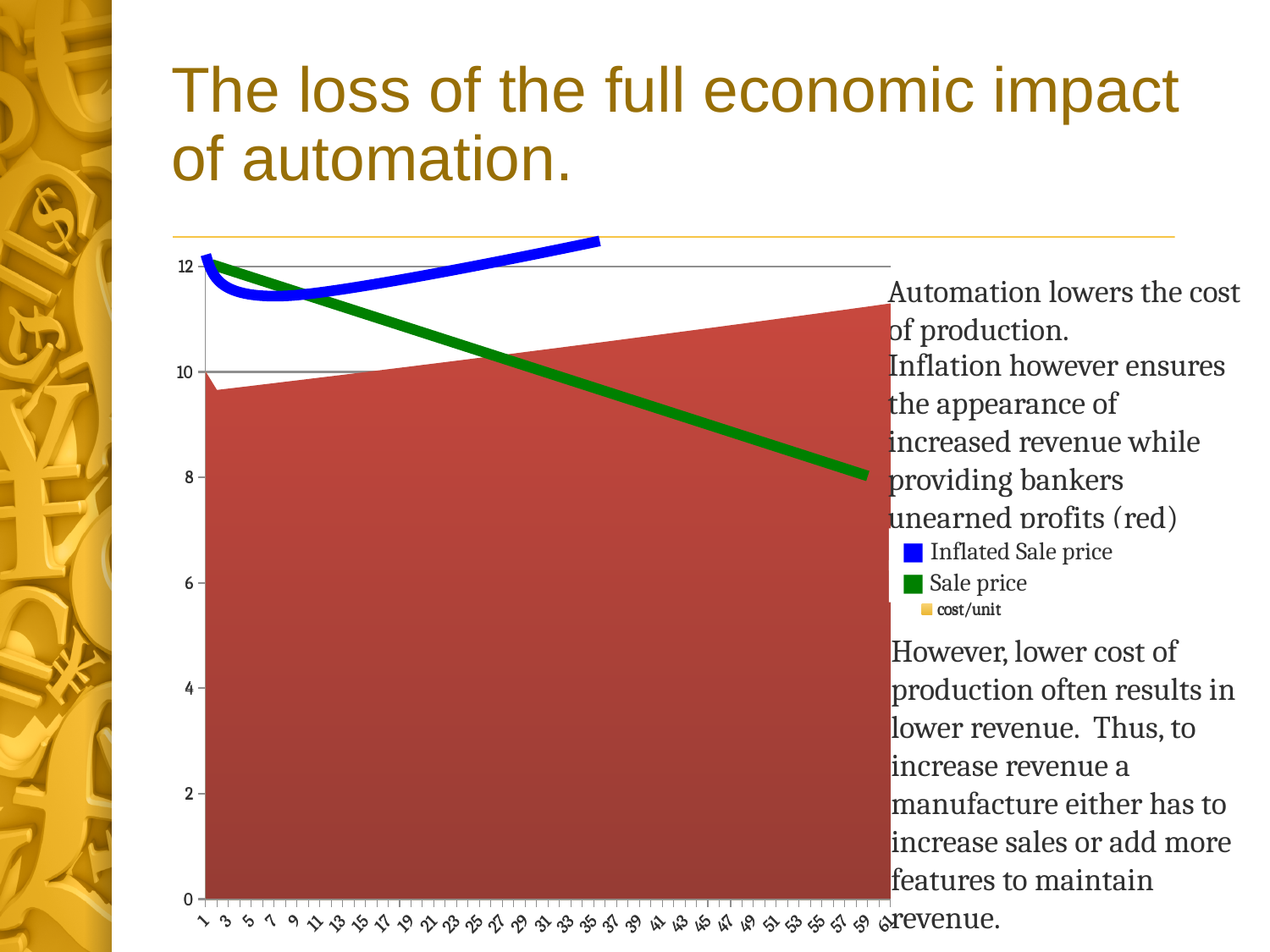
Which colour represents the Sale price series in the legend? green What is the Sale price value at x = 1? 12 What kind of chart is used for the cost/unit series? area chart What is the Sale price value at x = 61? 8 Is the Inflated Sale price value at x = 11 greater or less than 12? less Does the Sale price series rise or fall along the x axis? fall By how much does the Sale price fall between x = 1 and x = 61? 4 At x = 31, which is larger: the Inflated Sale price or the Sale price? Inflated Sale price Is the Sale price value at x = 41 greater or less than 10? less How many series does the chart legend list? 3